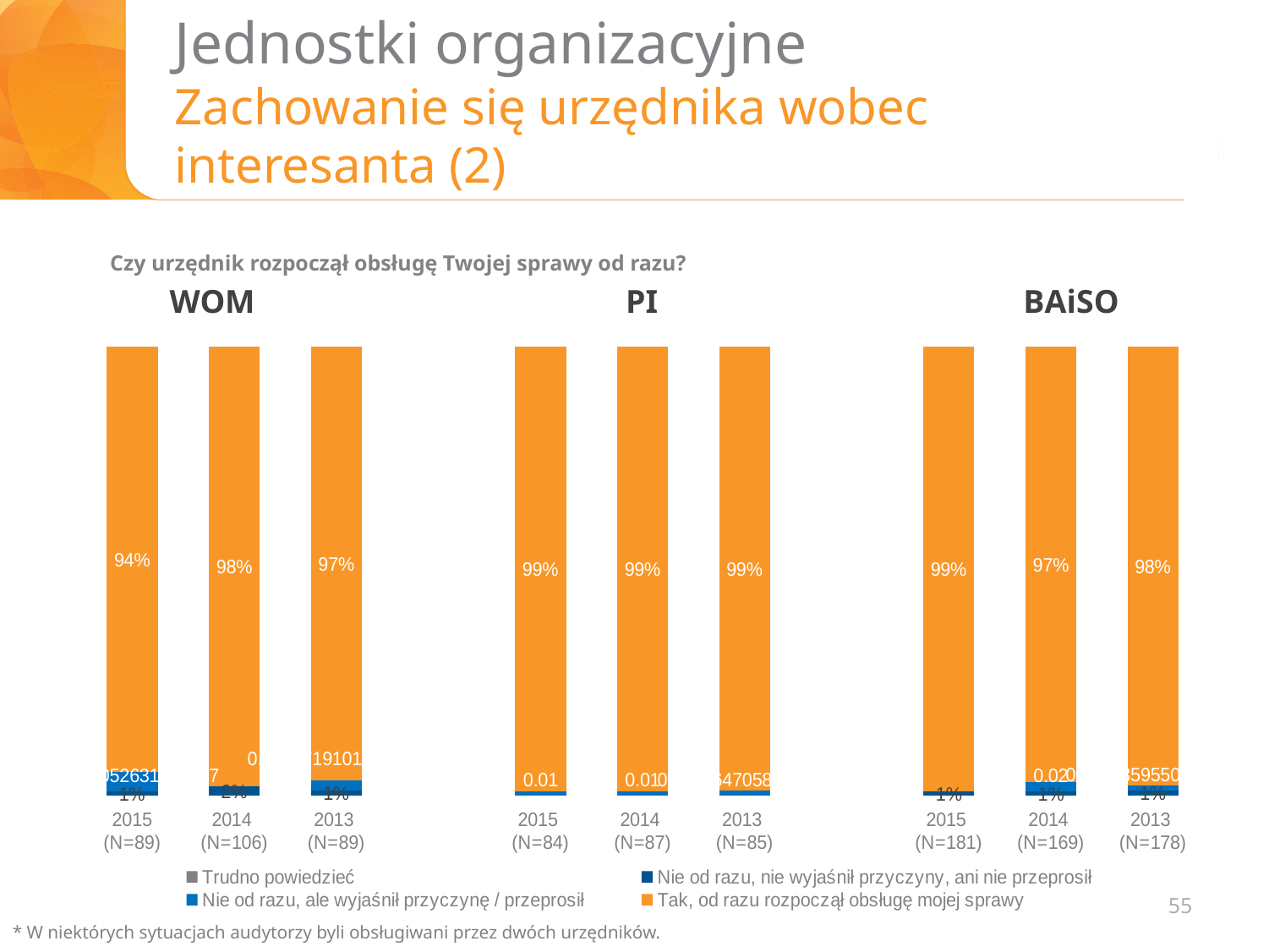
In the BAiSO chart, which year has the highest share of "Tak, od razu rozpoczął obsługę mojej sprawy"? 2015 (N=181) In the WOM chart, what is the difference between the orange segment values for 2014 and 2015? 4 percentage points In the WOM chart, which year has the lowest share of "Tak, od razu rozpoczął obsługę mojej sprawy"? 2015 (N=89) In the WOM chart, what is the value of the orange segment for 2013 (N=89)? 97% How many series does the legend list for the charts on this slide? 4 In the WOM chart, what is the value of the orange "Tak, od razu rozpoczął obsługę mojej sprawy" segment for 2014 (N=106)? 98% What type of chart is used for WOM, PI and BAiSO on this slide? Stacked bar chart In the WOM chart, what percentage of respondents in 2015 (N=89) said the official started handling their case right away ("Tak, od razu rozpoczął obsługę mojej sprawy")? 94% In the PI chart, what is the value of the orange "Tak, od razu rozpoczął obsługę mojej sprawy" segment for 2015 (N=84)? 99% In the BAiSO chart, what is the value of the orange segment for 2013 (N=178)? 98% In the BAiSO chart, what is the value of the orange segment for 2014 (N=169)? 97% In the WOM chart, is the orange segment larger for 2014 or for 2015? 2014